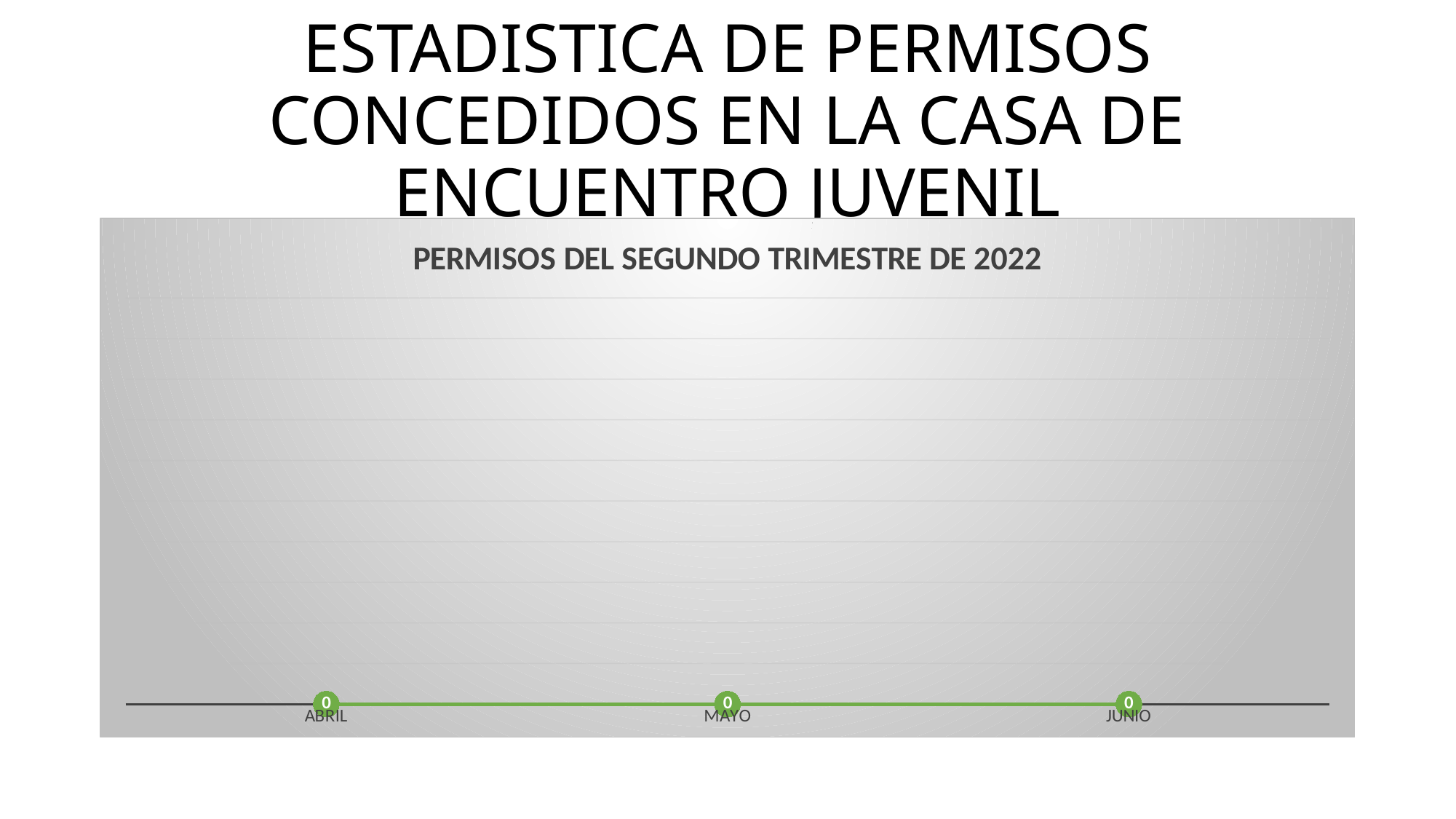
What is the value for MAYO? 0 What is the difference between the values for MAYO and ABRIL? 0 What is the value for ABRIL? 0 What is the difference between the values for ABRIL and JUNIO? 0 What kind of chart is shown on the slide? line chart What is the title of the chart? PERMISOS DEL SEGUNDO TRIMESTRE DE 2022 Do the values rise, fall or stay the same from ABRIL to JUNIO? stay the same How many months are plotted on the x axis? 3 Which month is the first category on the x axis? ABRIL What is the value for JUNIO? 0